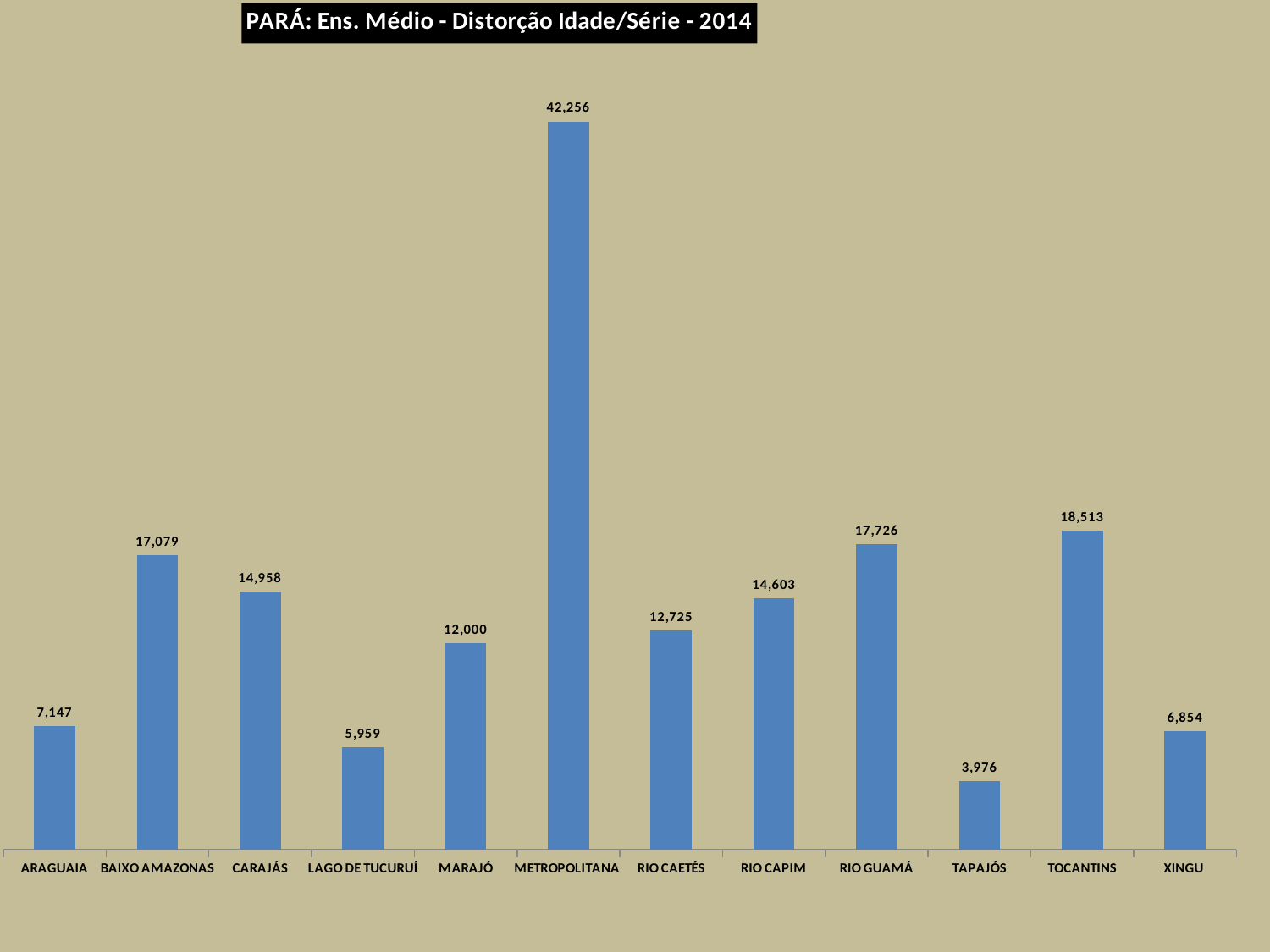
What is the value for TAPAJÓS? 3,976 What is the difference between the values for BAIXO AMAZONAS and CARAJÁS? 2,121 Which category has the highest value? METROPOLITANA Which is larger, the value for RIO CAPIM or the value for RIO CAETÉS? RIO CAPIM Which is larger, the value for ARAGUAIA or the value for XINGU? ARAGUAIA What is the value for METROPOLITANA? 42,256 What is the value for MARAJÓ? 12,000 What is the difference between the values for TOCANTINS and RIO GUAMÁ? 787 Which category has the lowest value? TAPAJÓS What kind of chart is shown on the slide? Bar chart How many categories are shown on the x axis? 12 What is the title of the chart? PARÁ: Ens. Médio - Distorção Idade/Série - 2014